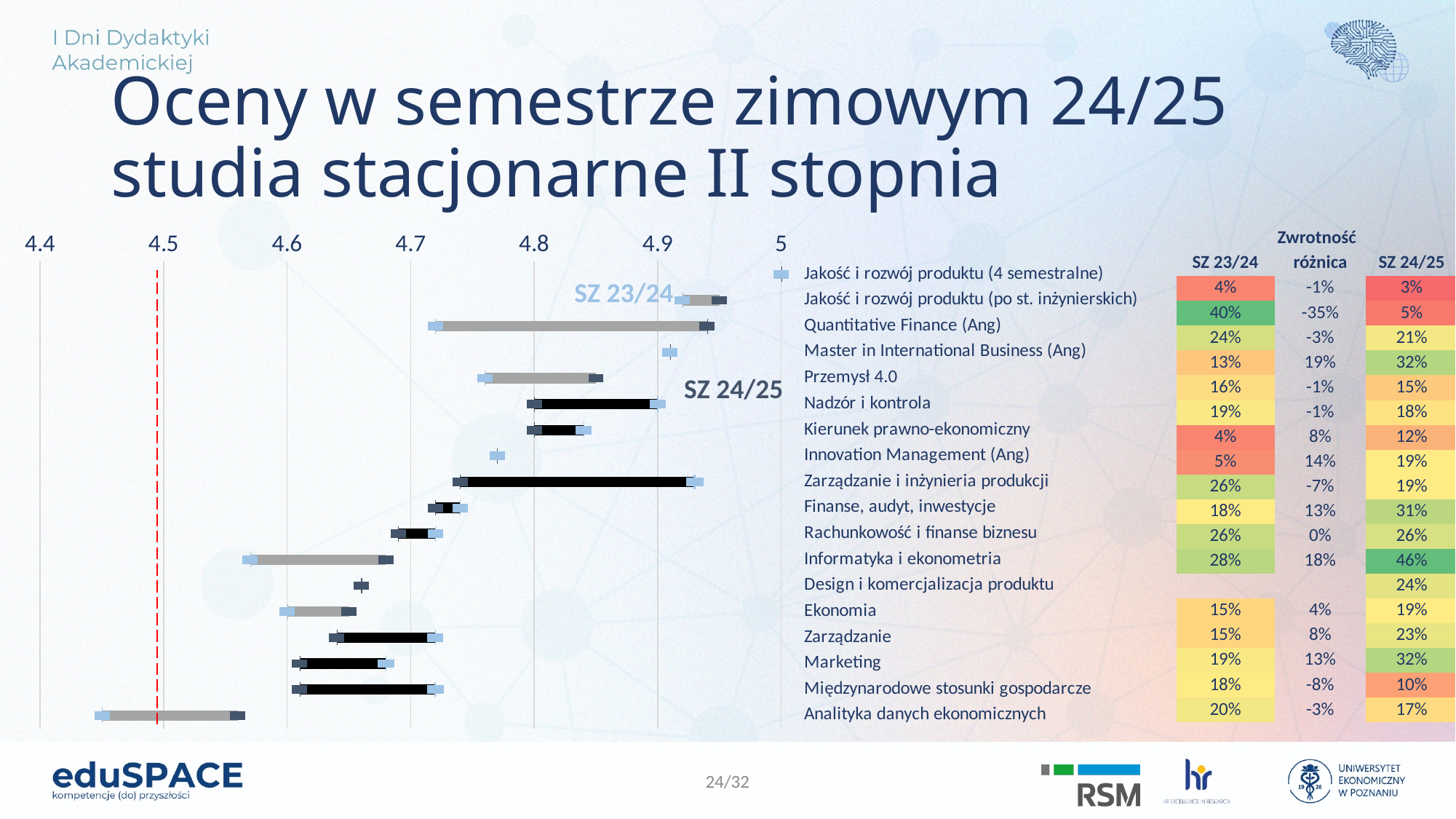
In the Zwrotność table, what is the 'różnica' value for Quantitative Finance (Ang)? -35% What kind of chart is shown on the slide? bar chart In the Zwrotność table, which programme has the highest SZ 23/24 response rate? Quantitative Finance (Ang) How many study programmes (categories) are listed in the chart? 18 At what value on the x axis is the red dashed vertical line drawn? 4.5 Is the SZ 24/25 value for Informatyka i ekonometria greater or less than 4.7? less Which two semesters are compared in the chart? SZ 23/24 and SZ 24/25 In the Zwrotność table, what is the SZ 24/25 response rate for Informatyka i ekonometria? 46% How many series does the chart compare? 2 Is the SZ 24/25 value for Ekonomia greater or less than 4.7? less Is the SZ 24/25 value for Jakość i rozwój produktu (po st. inżynierskich) greater or less than 4.9? greater